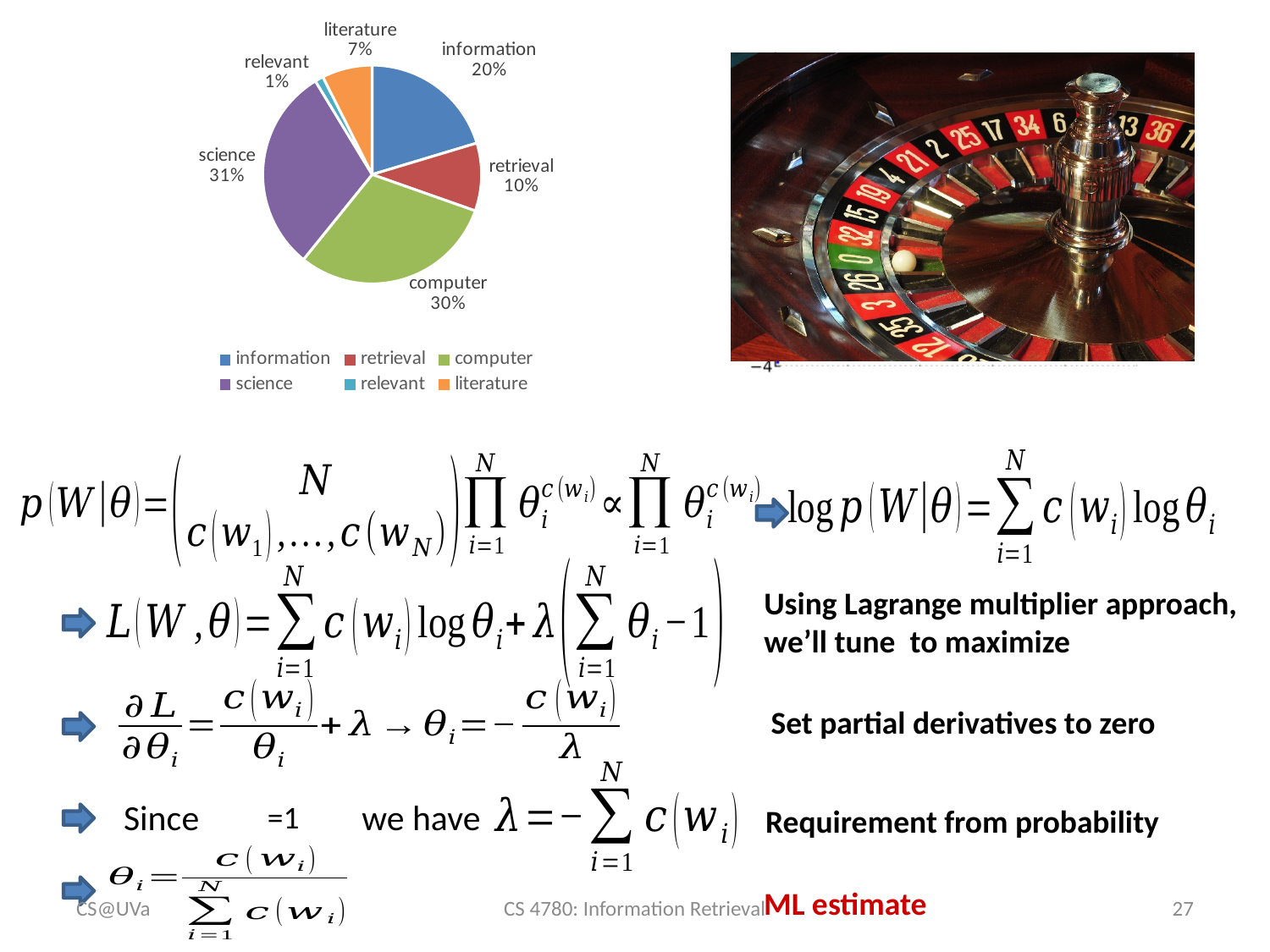
How many slices does the pie chart have? 6 What percentage of the pie does the literature slice represent? 7% Which slice is larger, information or literature? information Which category has the smallest share of the pie? relevant What percentage of the pie does the information slice represent? 20% What percentage of the pie does the retrieval slice represent? 10% Which category has the largest share of the pie? science What percentage of the pie does the science slice represent? 31% What kind of chart is shown on the slide? pie chart How many entries does the legend of the pie chart list? 6 What colour is the computer slice in the pie chart? green What is the difference in percentage points between the computer slice and the retrieval slice? 20